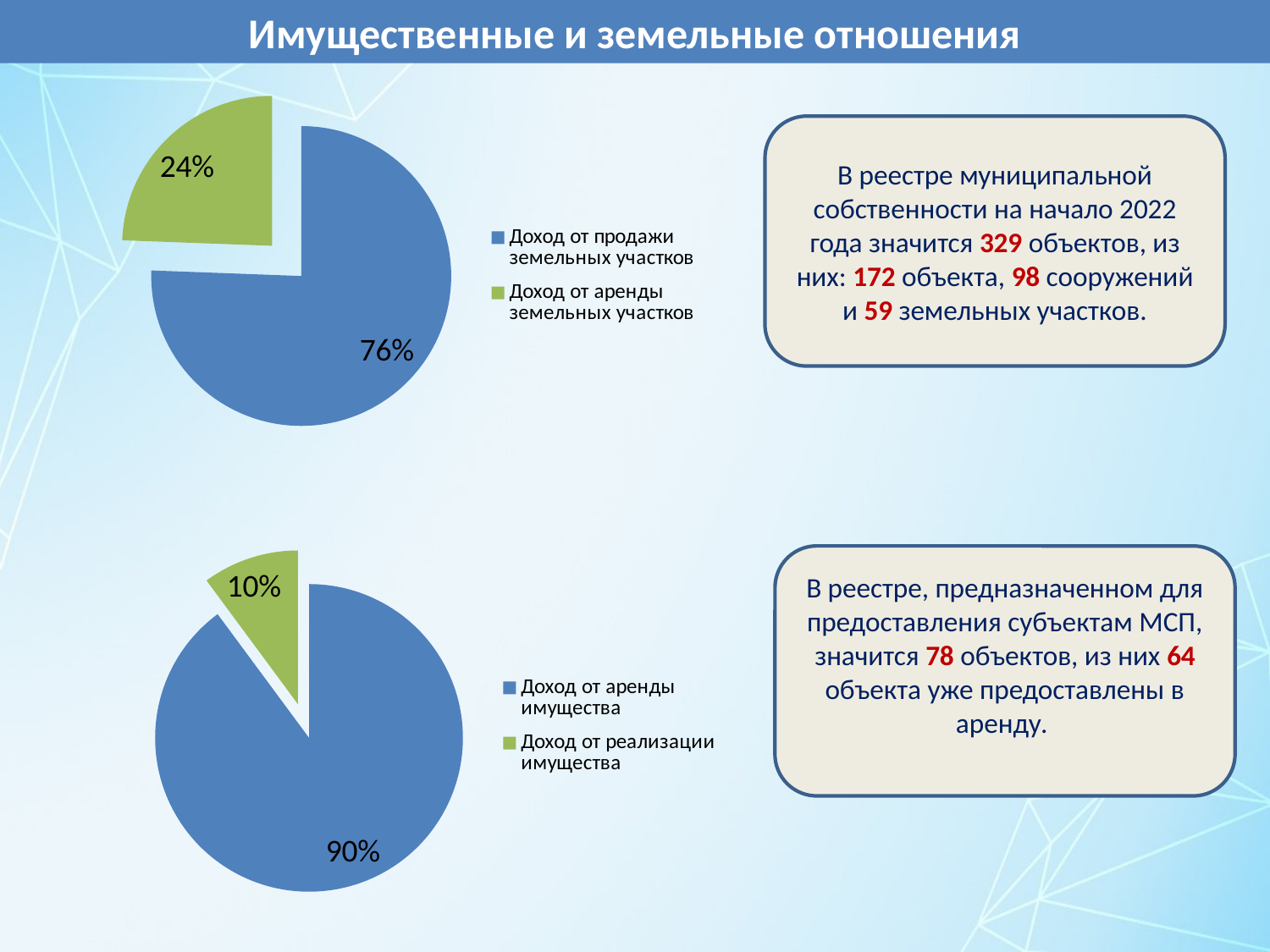
In the top pie chart, what share is labelled for 'Доход от продажи земельных участков'? 76% In the bottom pie chart, what share is labelled for 'Доход от аренды имущества'? 90% In the top pie chart, what share is labelled for 'Доход от аренды земельных участков'? 24% In the top pie chart, which category has the largest slice? Доход от продажи земельных участков In the bottom pie chart, what is the difference in percentage points between the two slices? 80 In the bottom pie chart, which is larger: 'Доход от аренды имущества' or 'Доход от реализации имущества'? Доход от аренды имущества In the bottom pie chart, which category has the smallest slice? Доход от реализации имущества What type of chart is the top chart on the slide? Pie chart In the top pie chart, what colour is the slice for 'Доход от аренды земельных участков'? Green In the top pie chart, what is the difference in percentage points between the two slices? 52 How many categories does the legend of the top pie chart list? 2